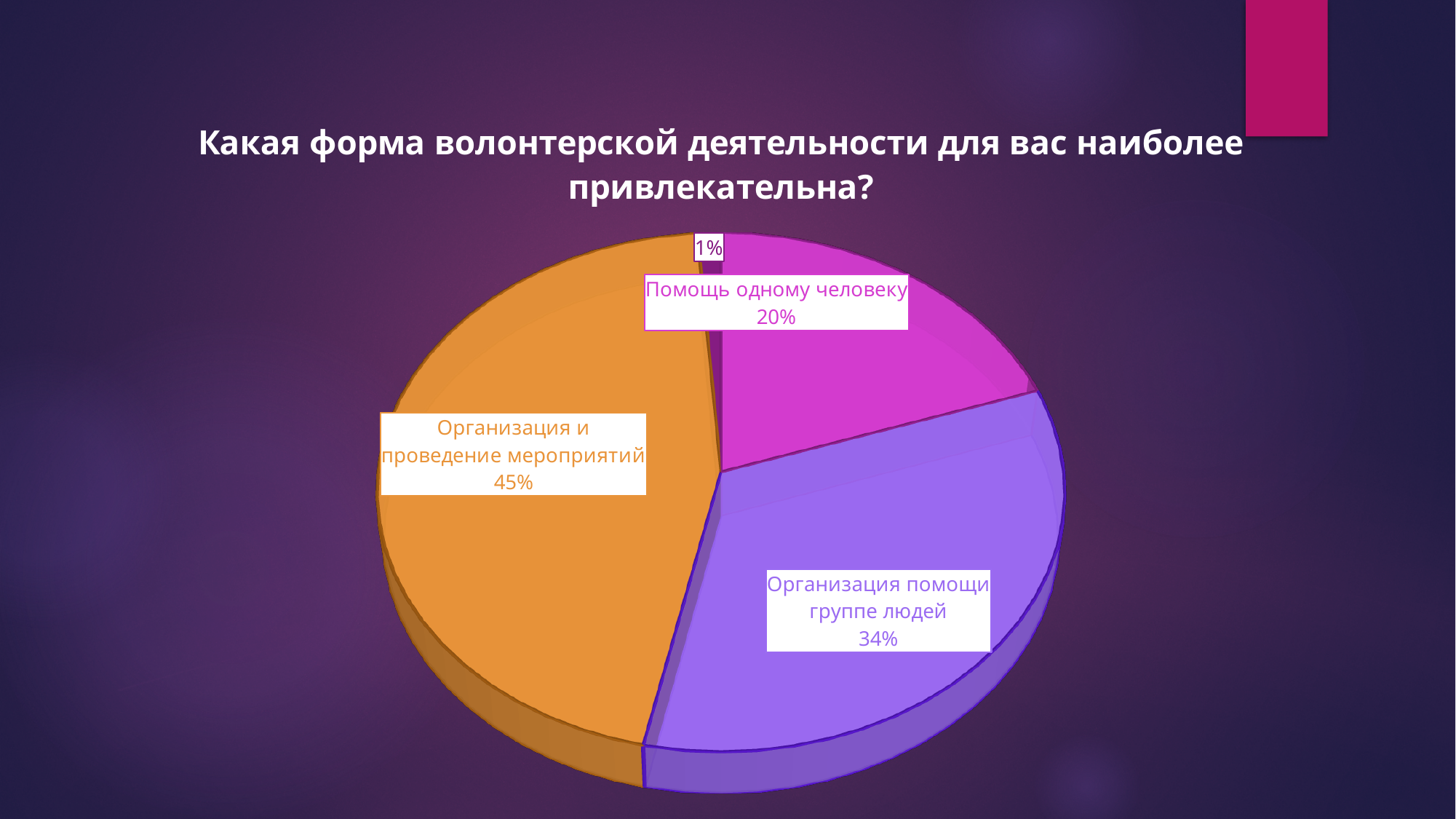
What share of the pie does "Помощь одному человеку" have? 20% What colour is the slice for "Организация и проведение мероприятий"? Orange Which is larger: the slice for "Организация помощи группе людей" or the slice for "Помощь одному человеку"? Организация помощи группе людей What is the difference in percentage points between "Организация и проведение мероприятий" and "Помощь одному человеку"? 25 percentage points Which category has the largest slice of the pie? Организация и проведение мероприятий What share of the pie does "Организация помощи группе людей" have? 34% What is the title of the chart? Какая форма волонтерской деятельности для вас наиболее привлекательна? What share of the pie does "Организация и проведение мероприятий" have? 45% What is the difference in percentage points between "Организация помощи группе людей" and "Помощь одному человеку"? 14 percentage points How many slices does the pie chart have? 4 What is the difference in percentage points between "Организация и проведение мероприятий" and "Организация помощи группе людей"? 11 percentage points What kind of chart is shown on the slide? Pie chart